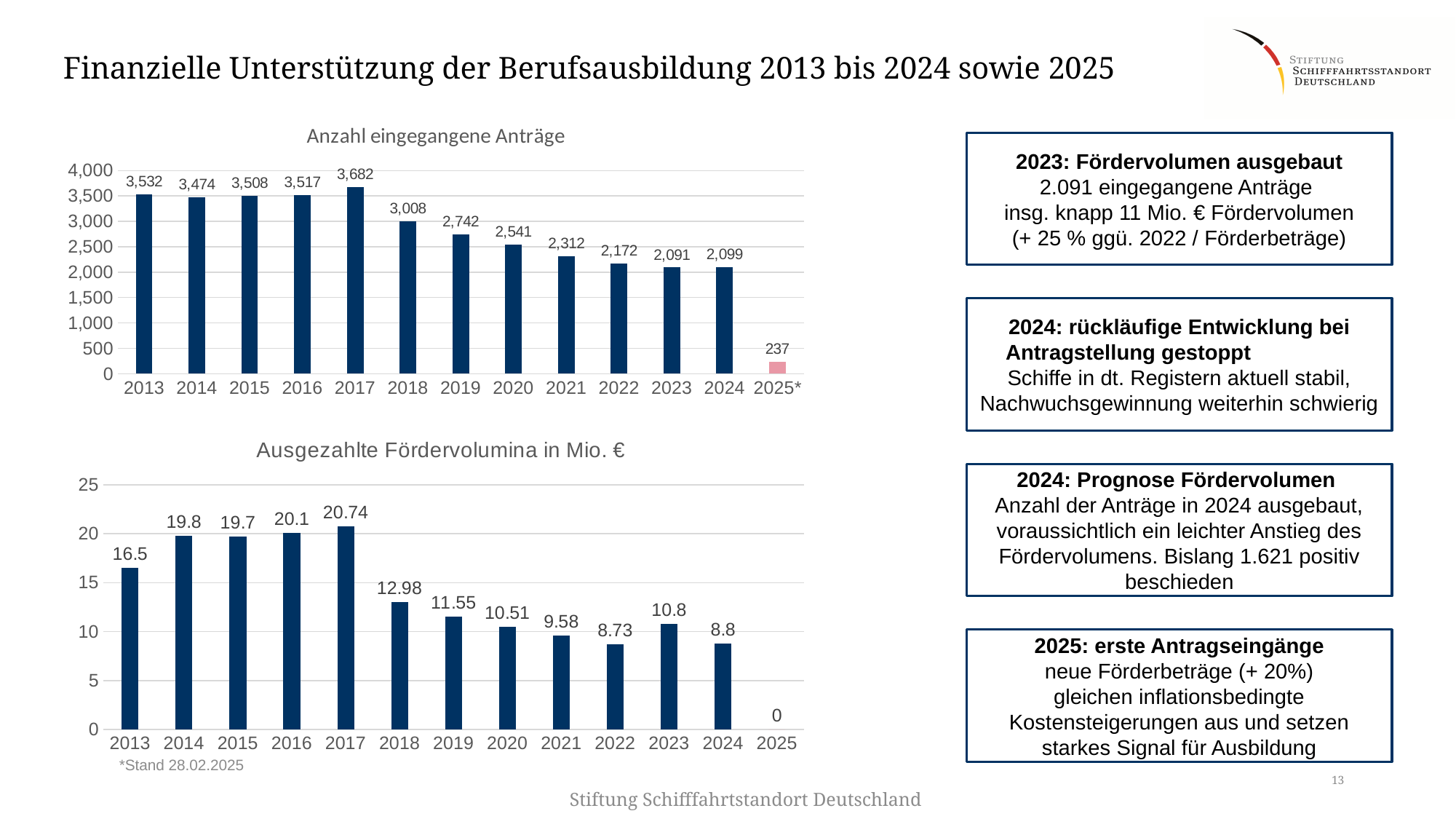
In the chart 'Ausgezahlte Fördervolumina in Mio. €', what is the value for 2023? 10.8 In the chart 'Anzahl eingegangene Anträge', do the values generally rise or fall from 2017 to 2023? Fall In the chart 'Ausgezahlte Fördervolumina in Mio. €', which year has the lowest value? 2025 In the chart 'Anzahl eingegangene Anträge', what is the value for 2025*? 237 In the chart 'Anzahl eingegangene Anträge', how many years are shown on the x axis? 13 In the chart 'Ausgezahlte Fördervolumina in Mio. €', what is the difference between the values for 2013 and 2014? 3.3 In the chart 'Ausgezahlte Fördervolumina in Mio. €', which year has the highest value? 2017 What kind of chart is 'Ausgezahlte Fördervolumina in Mio. €'? Bar chart In the chart 'Anzahl eingegangene Anträge', which year has the highest value? 2017 In the chart 'Anzahl eingegangene Anträge', what is the value for 2017? 3,682 In the chart 'Anzahl eingegangene Anträge', what is the difference between the values for 2017 and 2018? 674 In the chart 'Ausgezahlte Fördervolumina in Mio. €', is the value for 2022 larger or the value for 2023? 2023